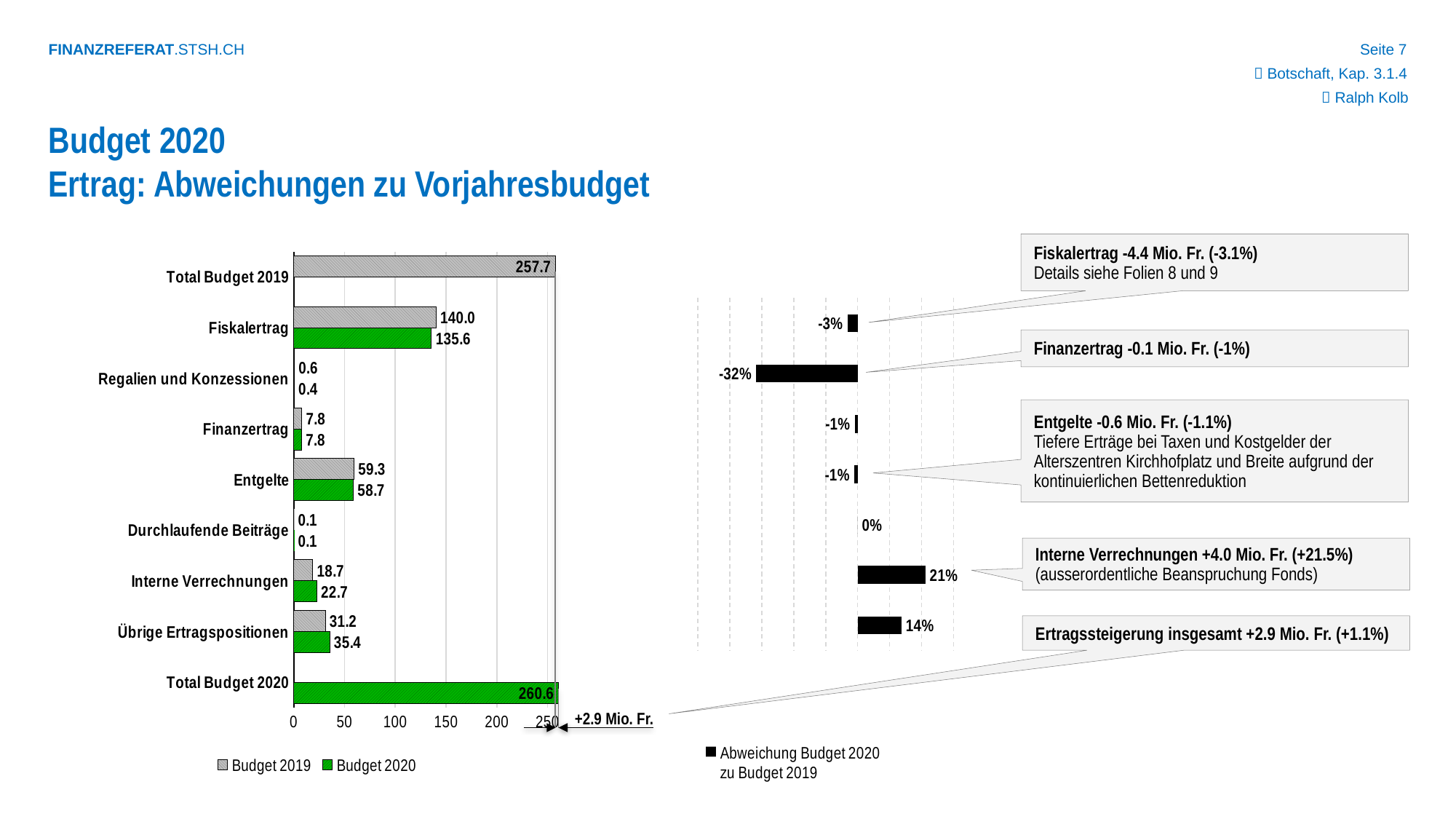
In the right chart (Abweichung Budget 2020 zu Budget 2019), what is the lowest percentage value shown? -32% In the right chart (Abweichung Budget 2020 zu Budget 2019), what is the highest percentage value shown? 21% In the left chart, what is the Budget 2020 value for Fiskalertrag? 135.6 In the left chart, what is the difference between the Budget 2020 and Budget 2019 values for Interne Verrechnungen? 4.0 What are the two legend entries of the left chart? Budget 2019 and Budget 2020 What type of chart is the left chart? Bar chart In the left chart, by how much does Total Budget 2020 exceed Total Budget 2019? 2.9 In the left chart, what is the value shown for Total Budget 2020? 260.6 In the left chart, what is the Budget 2019 value for Entgelte? 59.3 How many series does the legend of the left chart list? 2 In the left chart, for Übrige Ertragspositionen, which is larger: Budget 2019 or Budget 2020? Budget 2020 In the left chart, apart from the two total bars, which category has the highest Budget 2020 value? Fiskalertrag